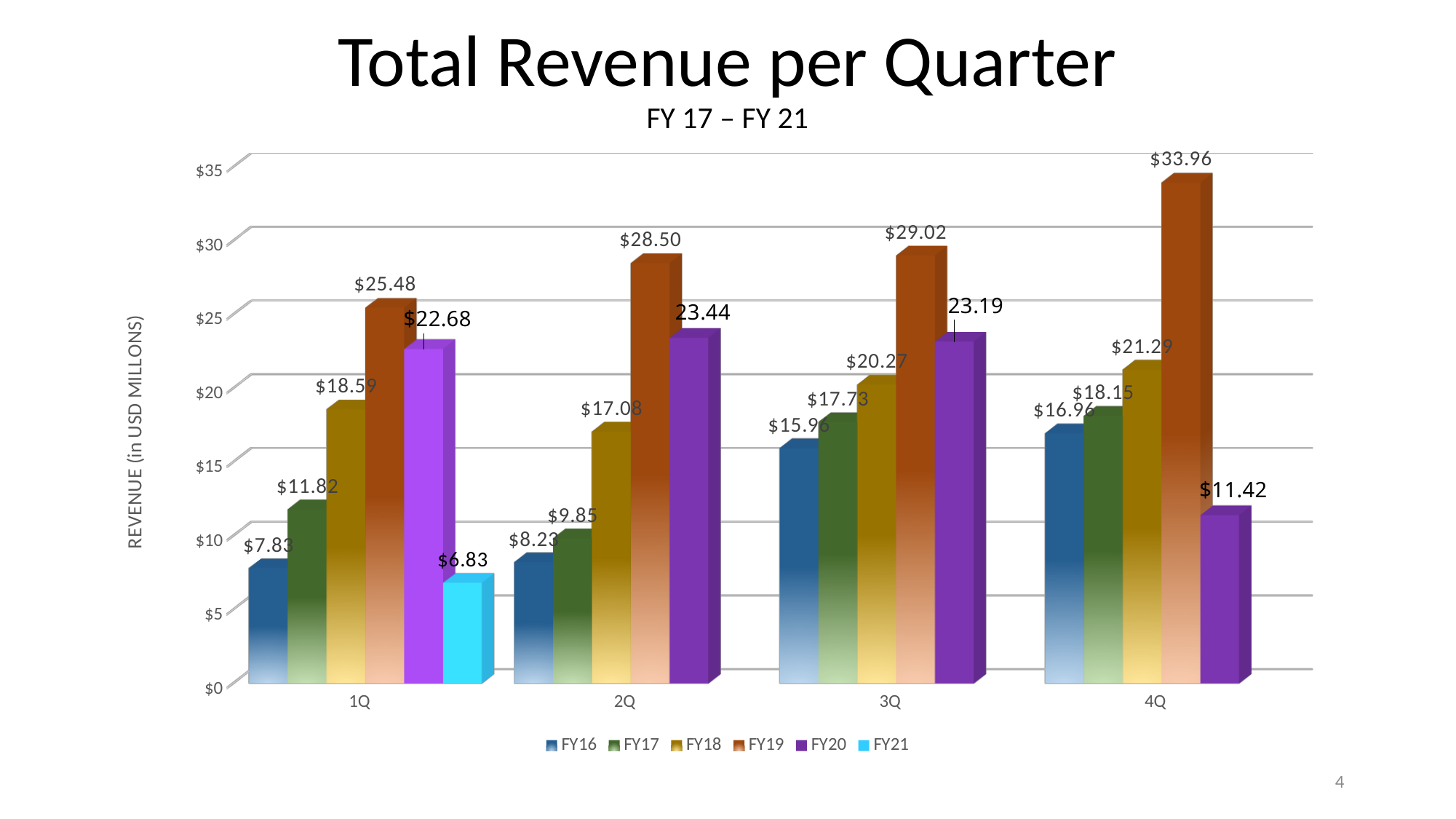
In which quarter is the FY20 revenue lowest? 4Q How many series does the legend list? 6 In which quarter is the FY19 revenue highest? 4Q What is the difference between the FY19 and FY18 revenue in 3Q? $8.75 Which is larger in 2Q: the FY17 revenue or the FY16 revenue? FY17 How many quarters are shown on the x axis? 4 What is the FY19 revenue for 4Q? $33.96 What kind of chart is shown on the slide? Bar chart What is the FY16 revenue for 1Q? $7.83 What is the FY21 revenue for 1Q? $6.83 What is the FY20 revenue for 2Q? 23.44 What is the label of the vertical axis? REVENUE (in USD MILLONS)